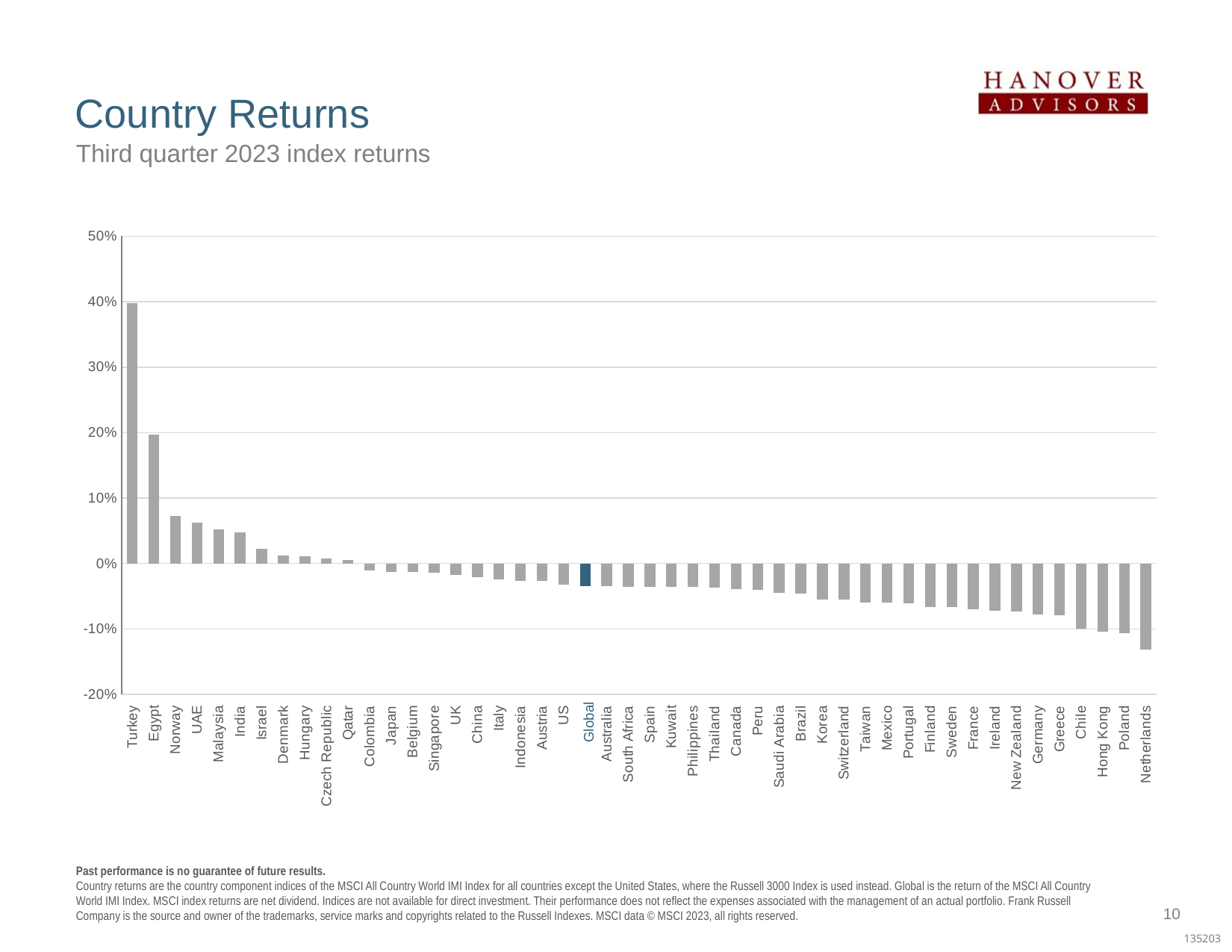
Which country has the lowest third quarter 2023 return? Netherlands Which country has the highest third quarter 2023 return? Turkey Is the value for Egypt greater or less than 10%? greater Is the value for Turkey greater or less than 30%? greater What kind of chart is shown on the slide? bar chart Is the value for Norway greater or less than 10%? less Do the values rise or fall moving from left to right along the x axis? fall How many bars are plotted on the chart? 48 Which has the larger return, Japan or Germany? Japan Which has the larger return, Egypt or Norway? Egypt